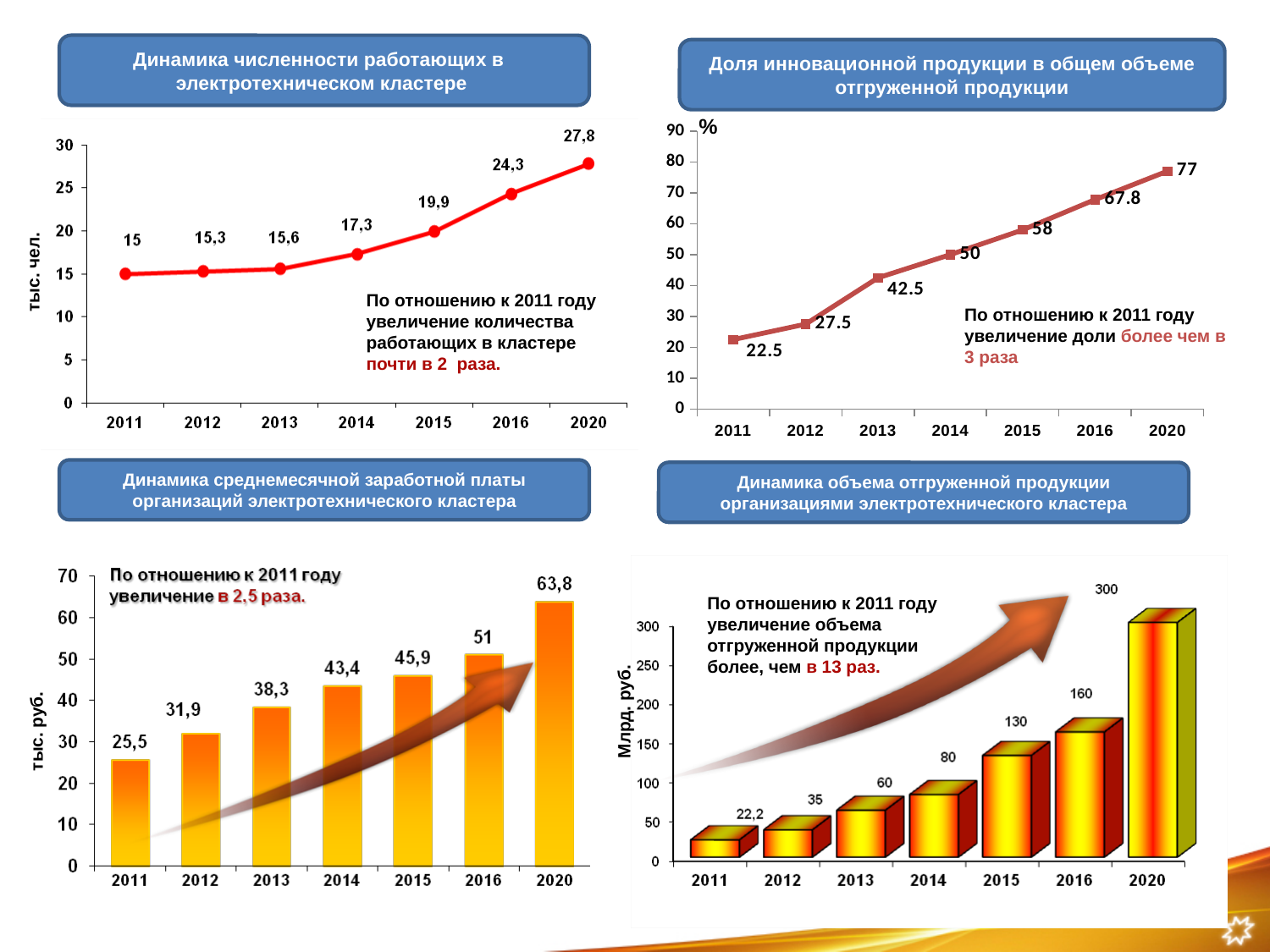
In the bottom-right chart (Динамика объема отгруженной продукции организациями электротехнического кластера), what is the value for 2016? 160 In the top-right chart (Доля инновационной продукции в общем объеме отгруженной продукции), do the values rise or fall from 2011 to 2020? rise In the bottom-right chart (Динамика объема отгруженной продукции организациями электротехнического кластера), which is larger, the value for 2015 or the value for 2014? 2015 In the bottom-left chart (Динамика среднемесячной заработной платы организаций электротехнического кластера), what is the value for 2014? 43,4 In the top-right chart (Доля инновационной продукции в общем объеме отгруженной продукции), what is the value for 2013? 42.5 In the bottom-left chart (Динамика среднемесячной заработной платы организаций электротехнического кластера), which year has the lowest value? 2011 What is the y-axis label of the bottom-right chart (Динамика объема отгруженной продукции организациями электротехнического кластера)? Млрд. руб. In the top-left chart (Динамика численности работающих в электротехническом кластере), which year has the highest value? 2020 In the top-left chart (Динамика численности работающих в электротехническом кластере), what is the difference between the 2020 value and the 2011 value? 12,8 In the top-left chart (Динамика численности работающих в электротехническом кластере), what is the value for 2015? 19,9 In the top-right chart (Доля инновационной продукции в общем объеме отгруженной продукции), how many data points are plotted? 7 What type of chart is the bottom-left chart (Динамика среднемесячной заработной платы организаций электротехнического кластера)? bar chart